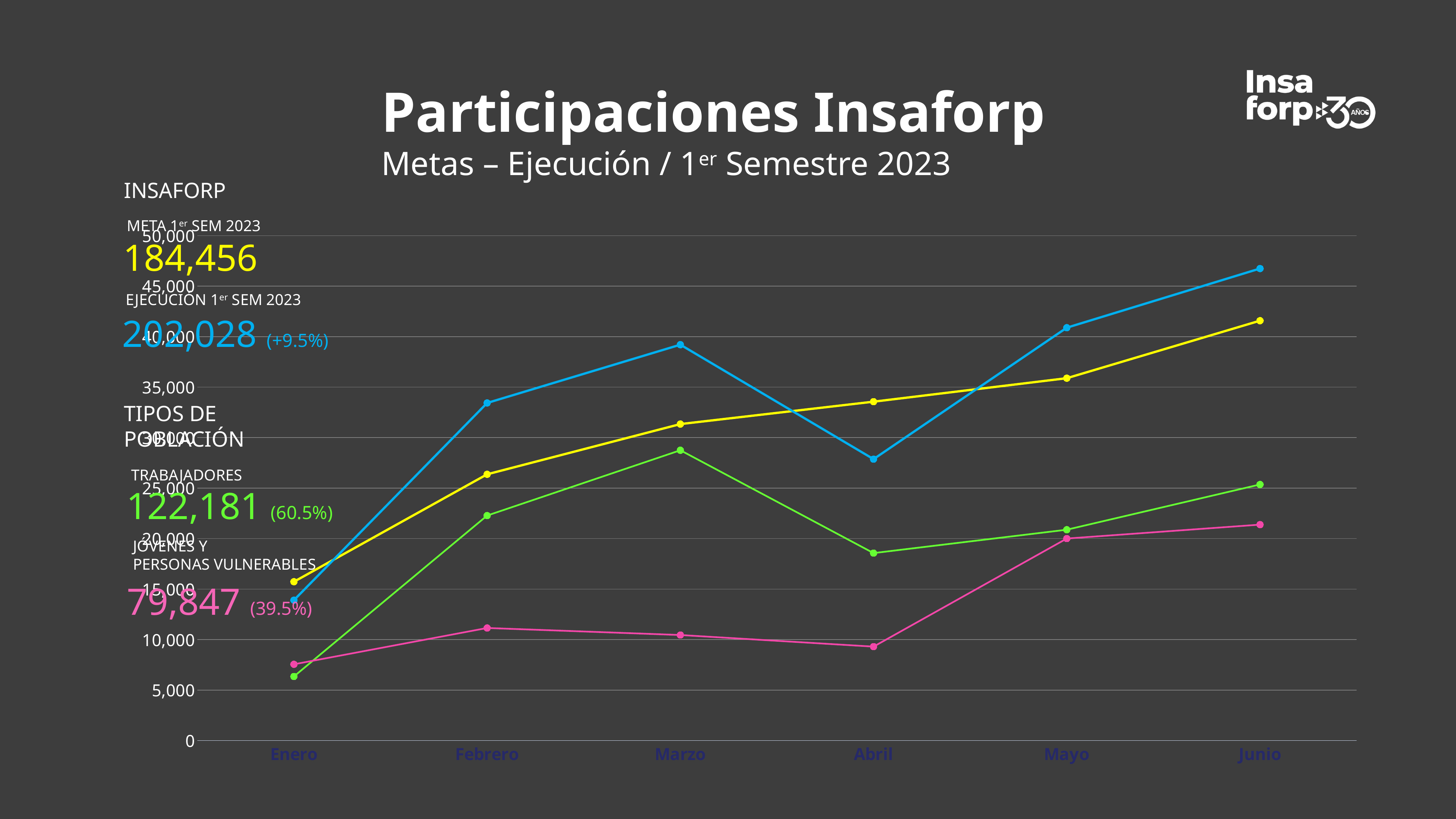
What kind of chart is shown on the slide? line chart In which month does the green line reach its highest value? Marzo Is the value of the blue line in Junio greater or less than 45,000? greater Is the value of the green line in Abril greater or less than 20,000? less How many lines are plotted on the chart? 4 In Marzo, which line is higher: the blue line or the yellow line? blue Does the yellow line rise or fall from Enero to Junio? rises How many months are shown on the x axis of the chart? 6 In Abril, which line is higher: the yellow line or the blue line? yellow In which month does the blue line reach its highest value? Junio Is the value of the yellow line in Enero greater or less than 20,000? less In which month is the blue line at its lowest value? Enero